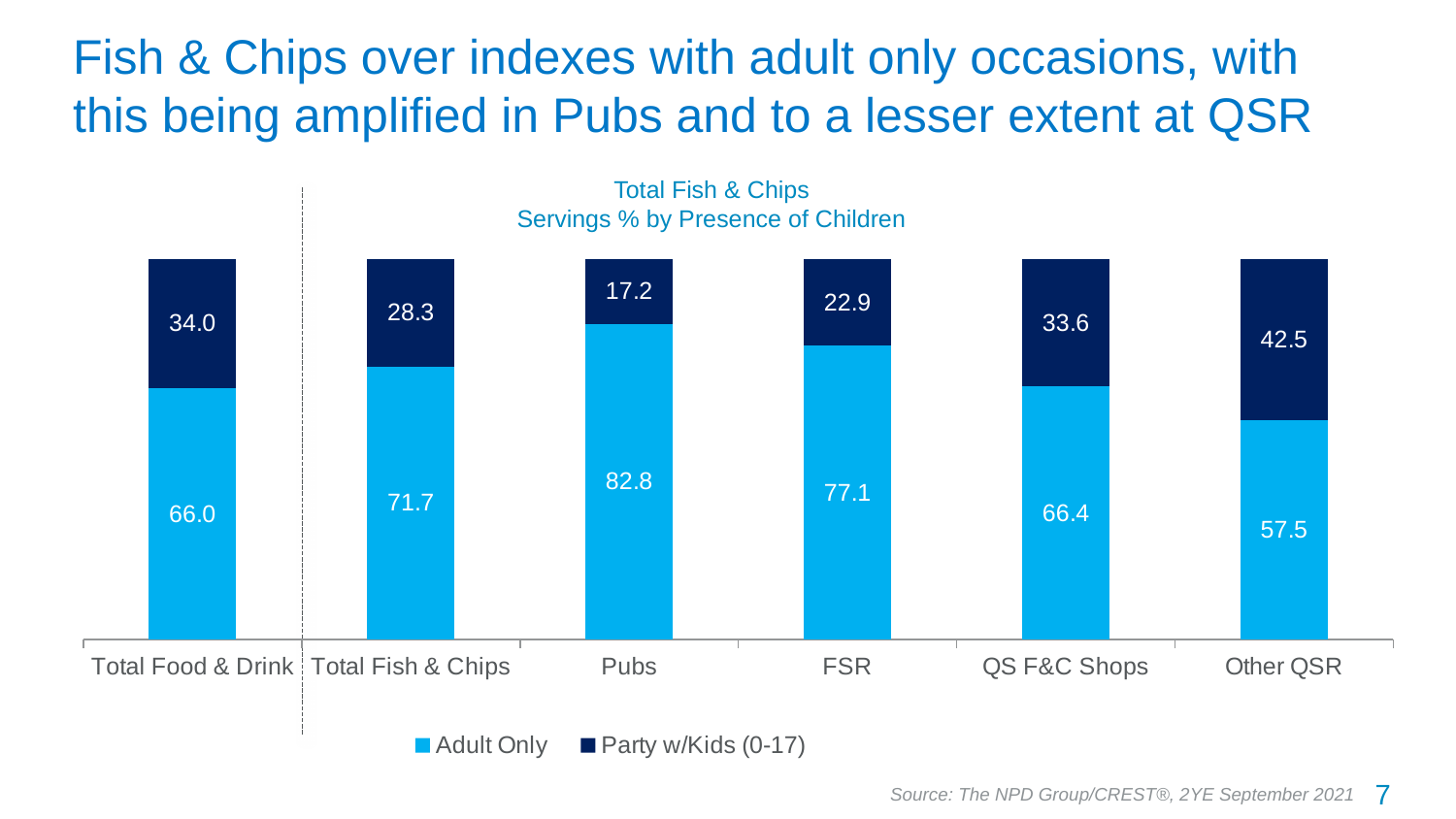
What kind of chart is this? Stacked bar chart How many series does the legend list? 2 Which category has the highest Adult Only value? Pubs What is the Party w/Kids (0-17) value for Other QSR? 42.5 What is the total of the stacked bar for Total Food & Drink? 100.0 Which category has the lowest Party w/Kids (0-17) value? Pubs What is the Adult Only value for Total Fish & Chips? 71.7 What is the Adult Only value for Pubs? 82.8 Which is larger, the Party w/Kids (0-17) value for FSR or for QS F&C Shops? QS F&C Shops What is the difference between the Adult Only values for Pubs and Other QSR? 25.3 What is the title of the chart? Total Fish & Chips Servings % by Presence of Children How many categories are shown on the x axis? 6